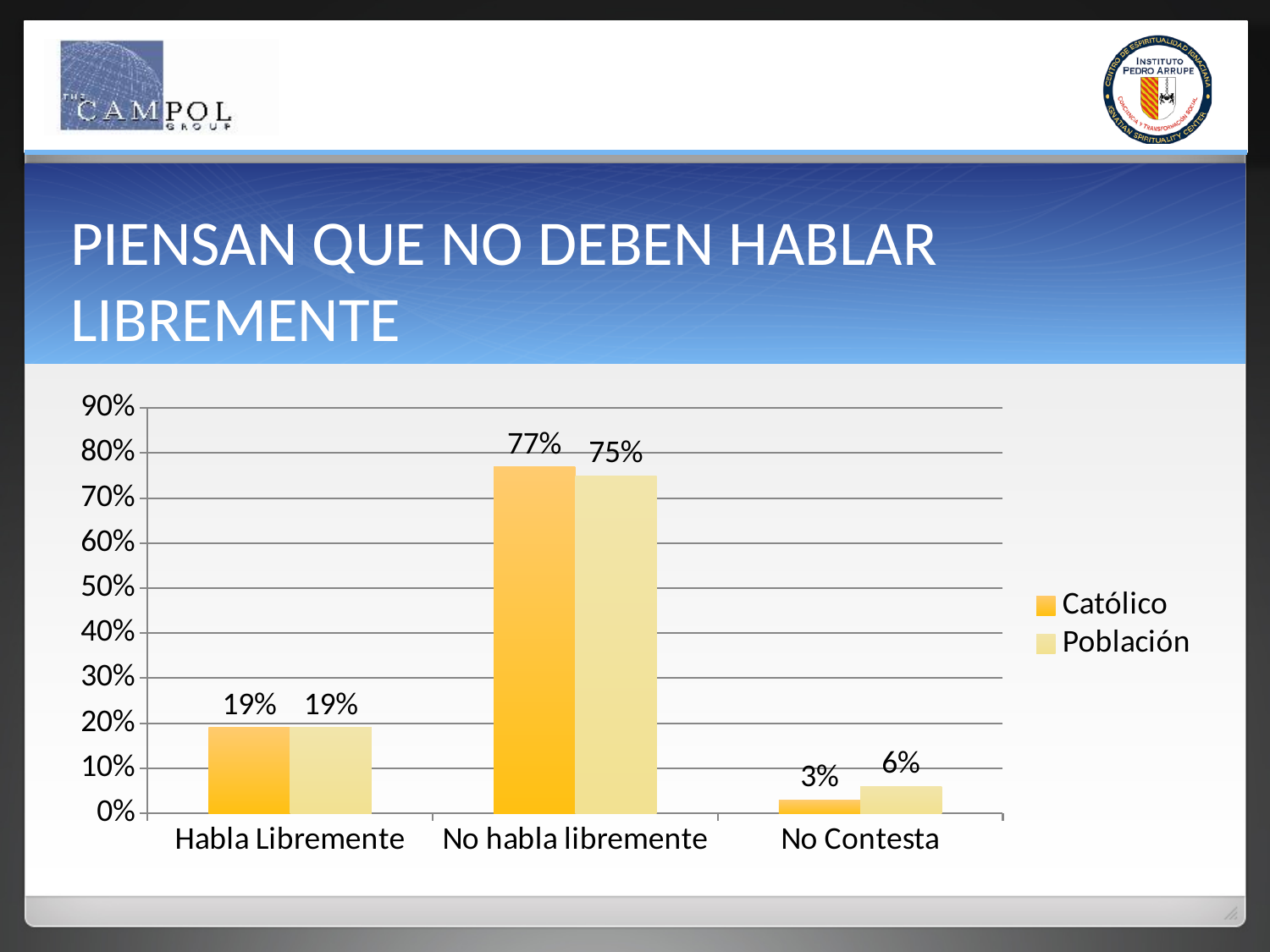
What is the title of the slide containing the chart? PIENSAN QUE NO DEBEN HABLAR LIBREMENTE What kind of chart is shown on the slide? Bar chart How many categories are shown on the x axis? 3 What is the value for Católico in the No habla libremente category? 77% What is the value for Católico in the Habla Libremente category? 19% In the No Contesta category, which series has the larger value, Católico or Población? Población Which category has the highest value for the Población series? No habla libremente Which category has the lowest value for the Católico series? No Contesta What is the difference between the Católico and Población values in the No habla libremente category? 2% What is the value for Población in the No Contesta category? 6% What is the difference between the Población and Católico values in the No Contesta category? 3% How many series does the legend list? 2